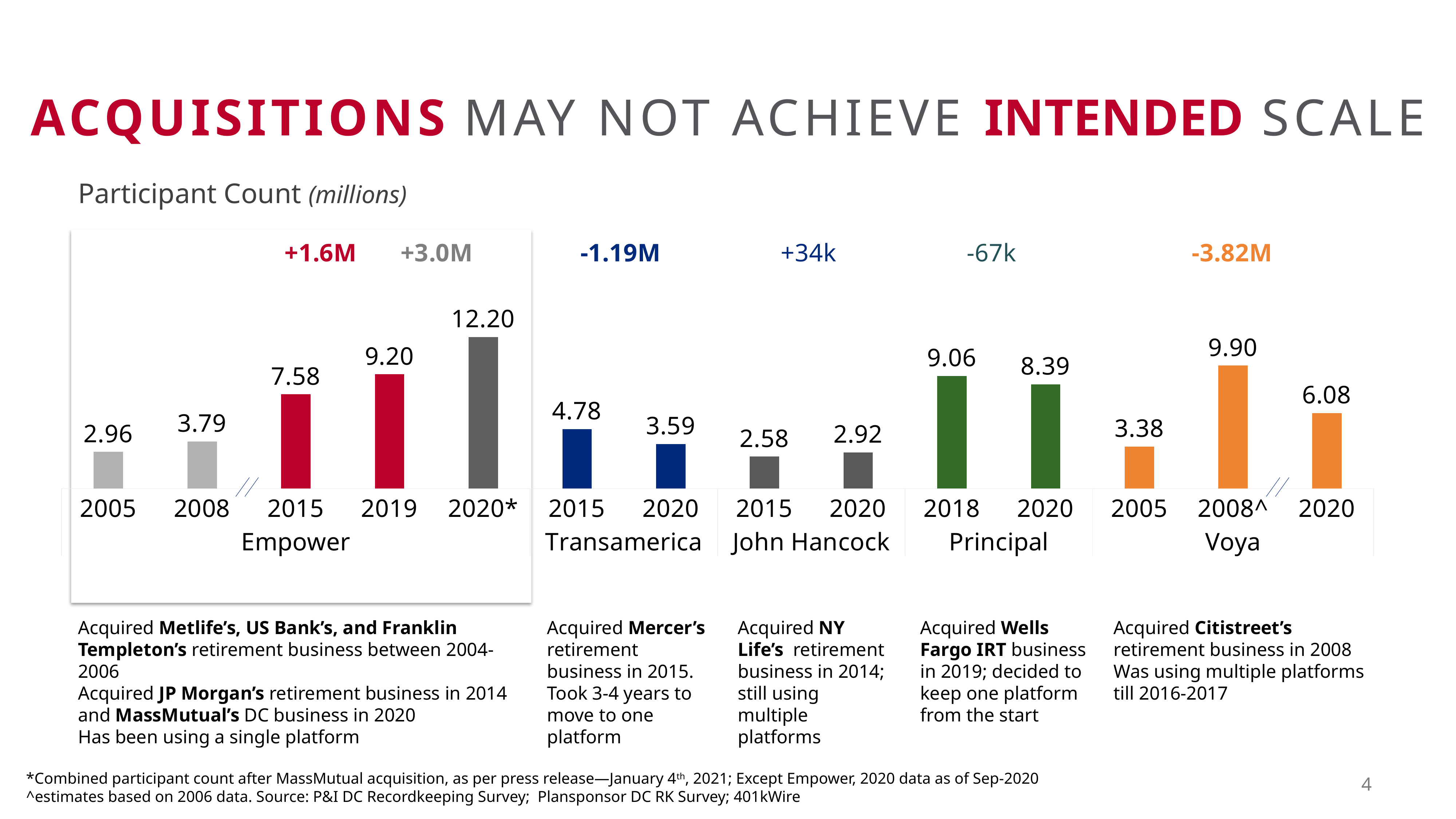
What is the participant count for Transamerica in 2015? 4.78 How many companies are shown on the chart? 5 Do John Hancock's participant counts rise or fall from 2015 to 2020? Rise What is the participant count for Principal in 2020? 8.39 What is the participant count for Voya in 2008^? 9.90 Which bar shows the lowest participant count on the chart? John Hancock 2015 What is the participant count for Empower in 2020*? 12.20 Which bar shows the highest participant count on the chart? Empower 2020* What is the difference between Voya's 2008^ and 2020 participant counts? 3.82 Which is larger, Transamerica's 2015 participant count or its 2020 participant count? 2015 What is the difference between Empower's 2019 and 2015 participant counts? 1.62 What type of chart is shown on the slide? Bar chart